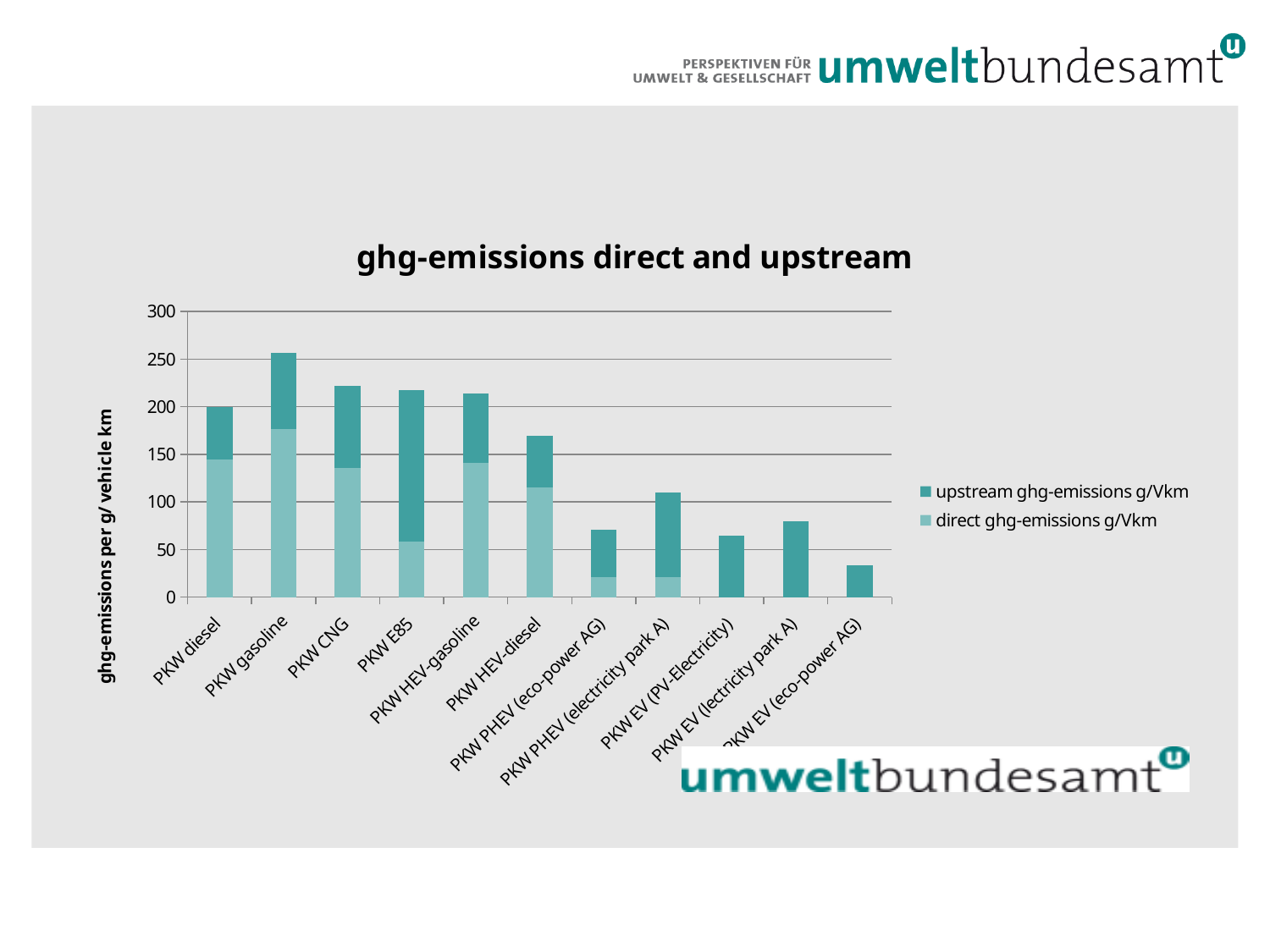
Which has a larger total value, PKW PHEV (eco-power AG) or PKW PHEV (electricity park A)? PKW PHEV (electricity park A) Is the total value for PKW gasoline greater or less than 250? greater Which has a larger total value, PKW diesel or PKW gasoline? PKW gasoline What kind of chart is shown on the slide? stacked bar chart Is the total value for PKW PHEV (electricity park A) greater or less than 100? greater Is the total value for PKW EV (PV-Electricity) greater or less than 100? less Which vehicle category has the highest total ghg-emissions? PKW gasoline How many series does the legend list? 2 How many vehicle categories are plotted on the x axis? 11 What is the label of the vertical axis? ghg-emissions per g/ vehicle km What is the title of the chart? ghg-emissions direct and upstream